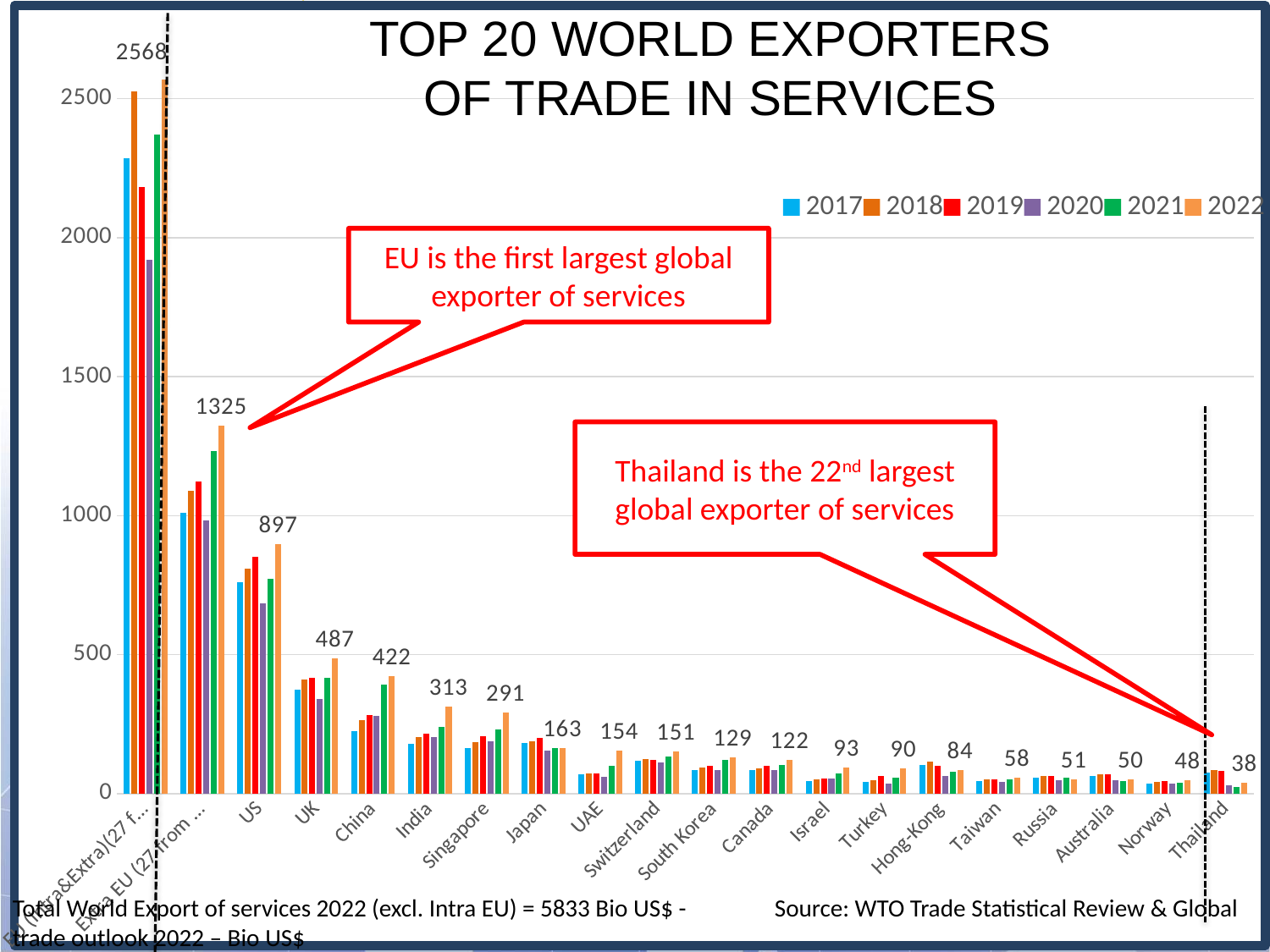
How many series does the legend list? 6 What kind of chart is shown on the slide? bar chart What is the difference between the 2022 values labelled for Japan and UAE? 9 What is the difference between the 2022 values labelled for the US and the UK? 410 How many exporter categories are shown on the x axis? 20 What is the 2022 value labelled for the UK? 487 Is the 2020 value for the US greater or less than 500? greater Which category has the lowest labelled 2022 value? Thailand What is the 2022 value labelled for Thailand? 38 Which has the larger 2022 value, India or Singapore? India Do the labelled 2022 values rise or fall moving from left to right along the x axis? fall What is the 2022 value labelled for the US? 897